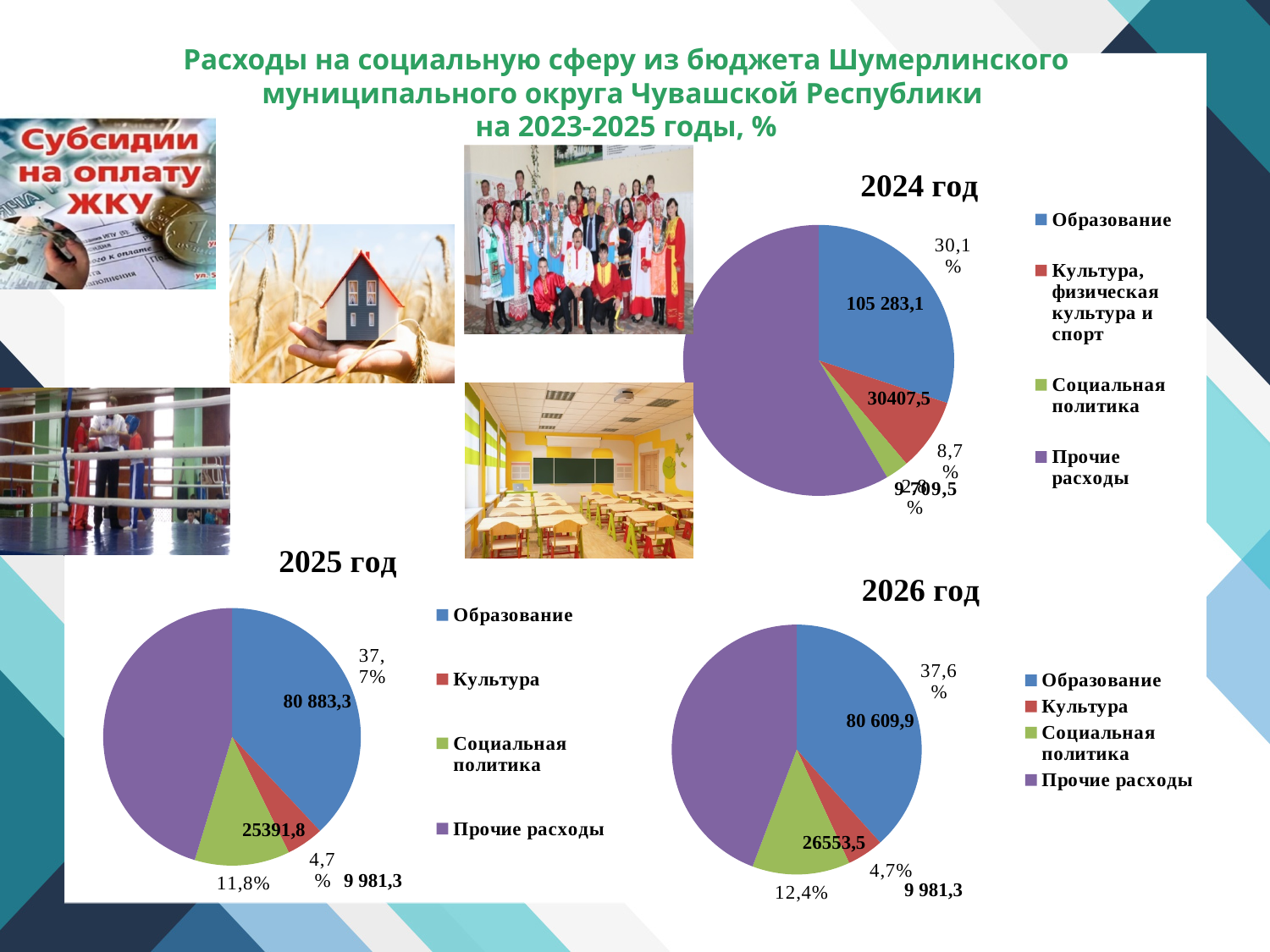
In the '2026 год' chart, what share of the pie does Социальная политика take? 12,4% In the '2026 год' chart, what is the value for Образование? 80 609,9 In the '2025 год' chart, what share of the pie does Социальная политика take? 11,8% In the '2025 год' chart, what is the value for Образование? 80 883,3 In the '2025 год' chart, which category has the smallest slice? Культура In the '2025 год' chart, what is the value for Социальная политика? 25391,8 How many entries does the legend of the '2024 год' chart list? 4 In the '2024 год' chart, what is the value for Культура, физическая культура и спорт? 30407,5 In the '2024 год' chart, what share of the pie does Образование take? 30,1% In the '2025 год' chart, which category has the largest slice? Прочие расходы What kind of chart is the '2024 год' chart? pie chart In the '2024 год' chart, what is the value for Образование? 105 283,1